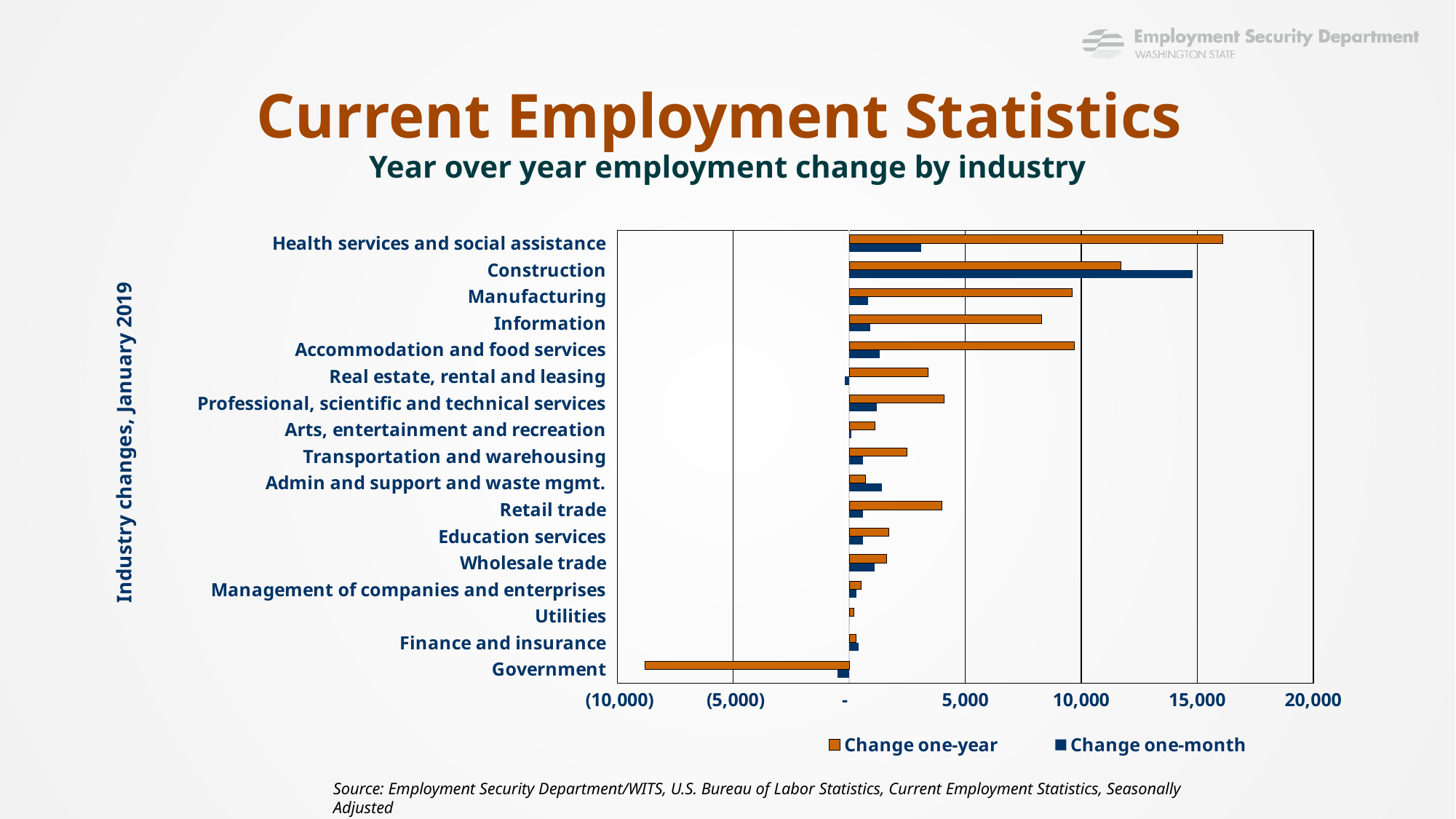
Is the Change one-year value for Health services and social assistance greater or less than 15,000? greater How many series does the legend list? 2 Is the Change one-year value for Government greater or less than (5,000)? less What are the two series named in the legend? Change one-year and Change one-month Which is larger: the Change one-month value for Construction or for Health services and social assistance? Construction Is the Change one-month value for Construction greater or less than 10,000? greater Which industry has the highest Change one-year value? Health services and social assistance How many industries are listed on the chart? 17 What kind of chart is shown on the slide? bar chart Which industry has the lowest Change one-year value? Government Which is larger: the Change one-year value for Construction or for Health services and social assistance? Health services and social assistance Which industry has the highest Change one-month value? Construction